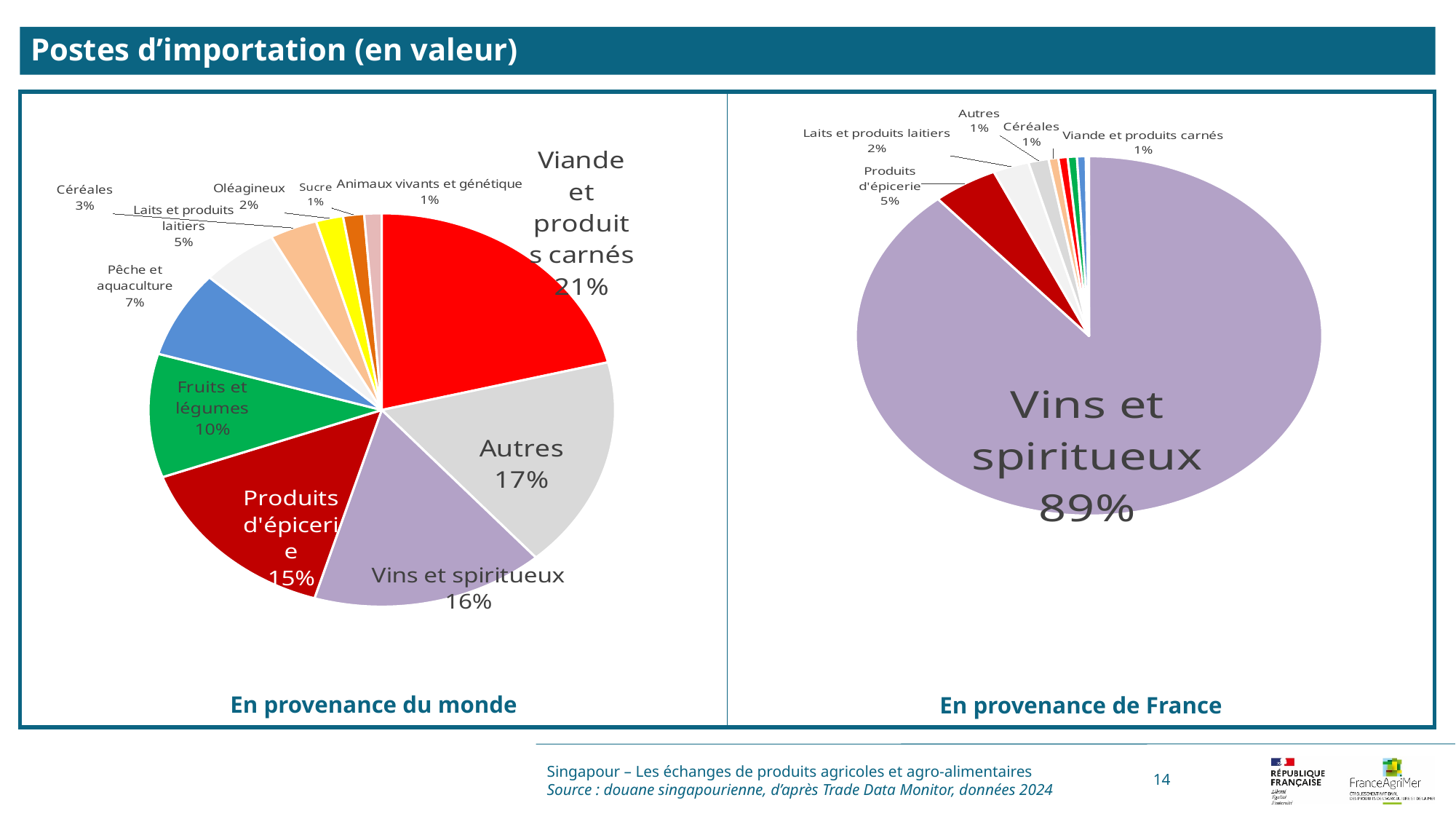
What is the title of the slide containing the two pie charts? Postes d'importation (en valeur) In the 'En provenance du monde' pie chart, what share does 'Viande et produits carnés' have? 21% In the 'En provenance de France' pie chart, what share does 'Vins et spiritueux' have? 89% In the 'En provenance du monde' pie chart, which is larger: 'Produits d'épicerie' or 'Pêche et aquaculture'? Produits d'épicerie What type of chart is used for 'En provenance de France'? Pie chart In the 'En provenance du monde' pie chart, which category has the largest share? Viande et produits carnés In the 'En provenance du monde' pie chart, what share does 'Fruits et légumes' have? 10% In the 'En provenance du monde' pie chart, what is the difference in percentage points between 'Autres' and 'Vins et spiritueux'? 1 percentage point In the 'En provenance de France' pie chart, what share does 'Produits d'épicerie' have? 5% In the 'En provenance de France' pie chart, what is the difference in percentage points between 'Vins et spiritueux' and 'Produits d'épicerie'? 84 percentage points How many categories are shown in the 'En provenance du monde' pie chart? 11